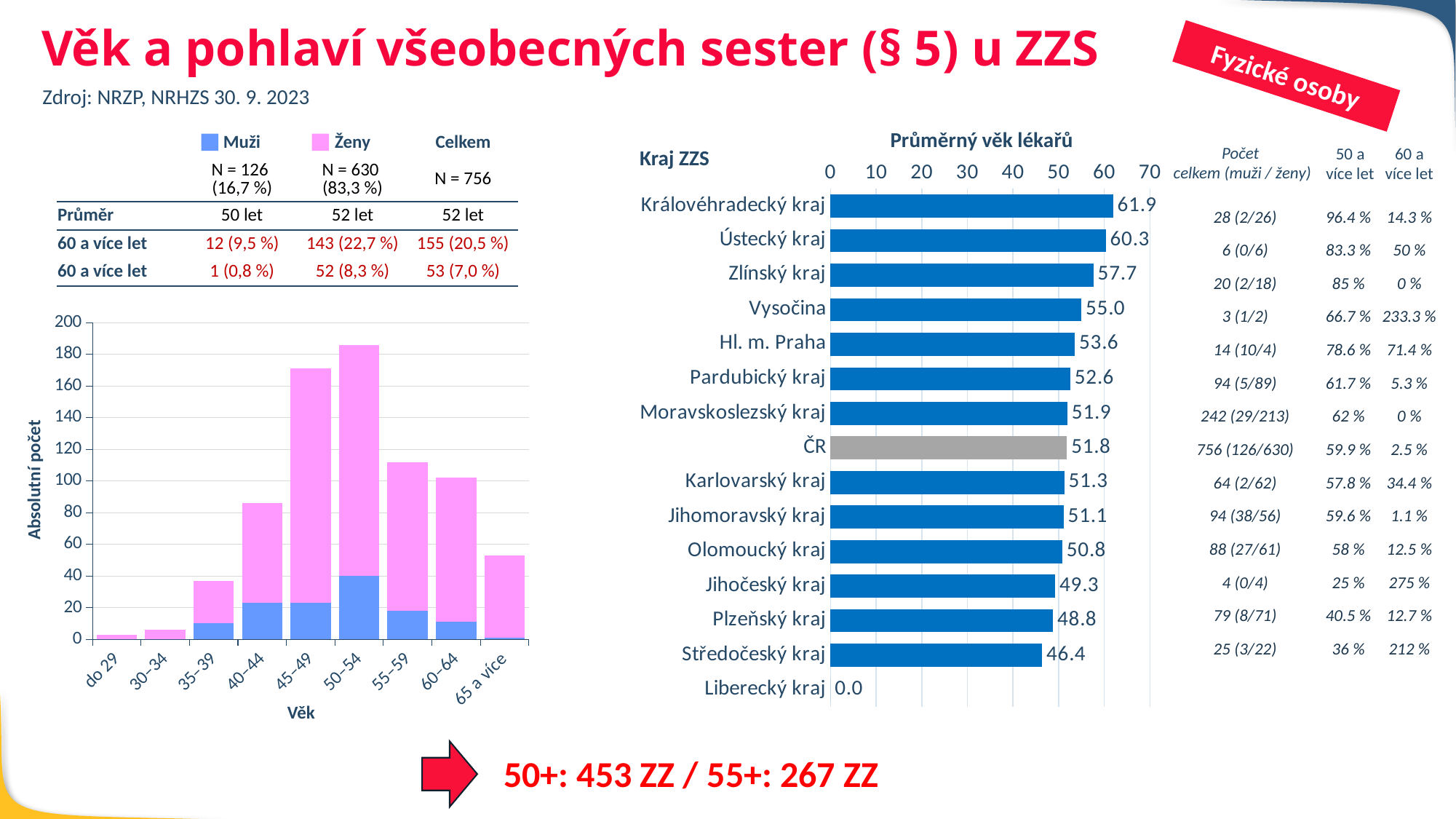
On the right chart (Průměrný věk lékařů), what is the value for ČR? 51.8 On the left chart (Absolutní počet by Věk), what kind of chart is it? Stacked bar chart On the right chart (Průměrný věk lékařů), which is larger, the value for Ústecký kraj or Zlínský kraj? Ústecký kraj On the right chart (Průměrný věk lékařů), what is the value for Královéhradecký kraj? 61.9 On the left chart (Absolutní počet by Věk), which age group has the shortest bar? do 29 On the left chart (Absolutní počet by Věk), is the total for the 45–49 group greater or less than 160? greater On the right chart (Průměrný věk lékařů), what is the value for Středočeský kraj? 46.4 On the right chart (Průměrný věk lékařů), what is the difference between Královéhradecký kraj and Středočeský kraj? 15.5 On the left chart (Absolutní počet by Věk), how many series does the legend list? 2 On the right chart (Průměrný věk lékařů), how many categories (bars) are listed on the vertical axis? 15 On the left chart (Absolutní počet by Věk), which age group has the tallest bar? 50–54 On the right chart (Průměrný věk lékařů), which region has the highest average age? Královéhradecký kraj